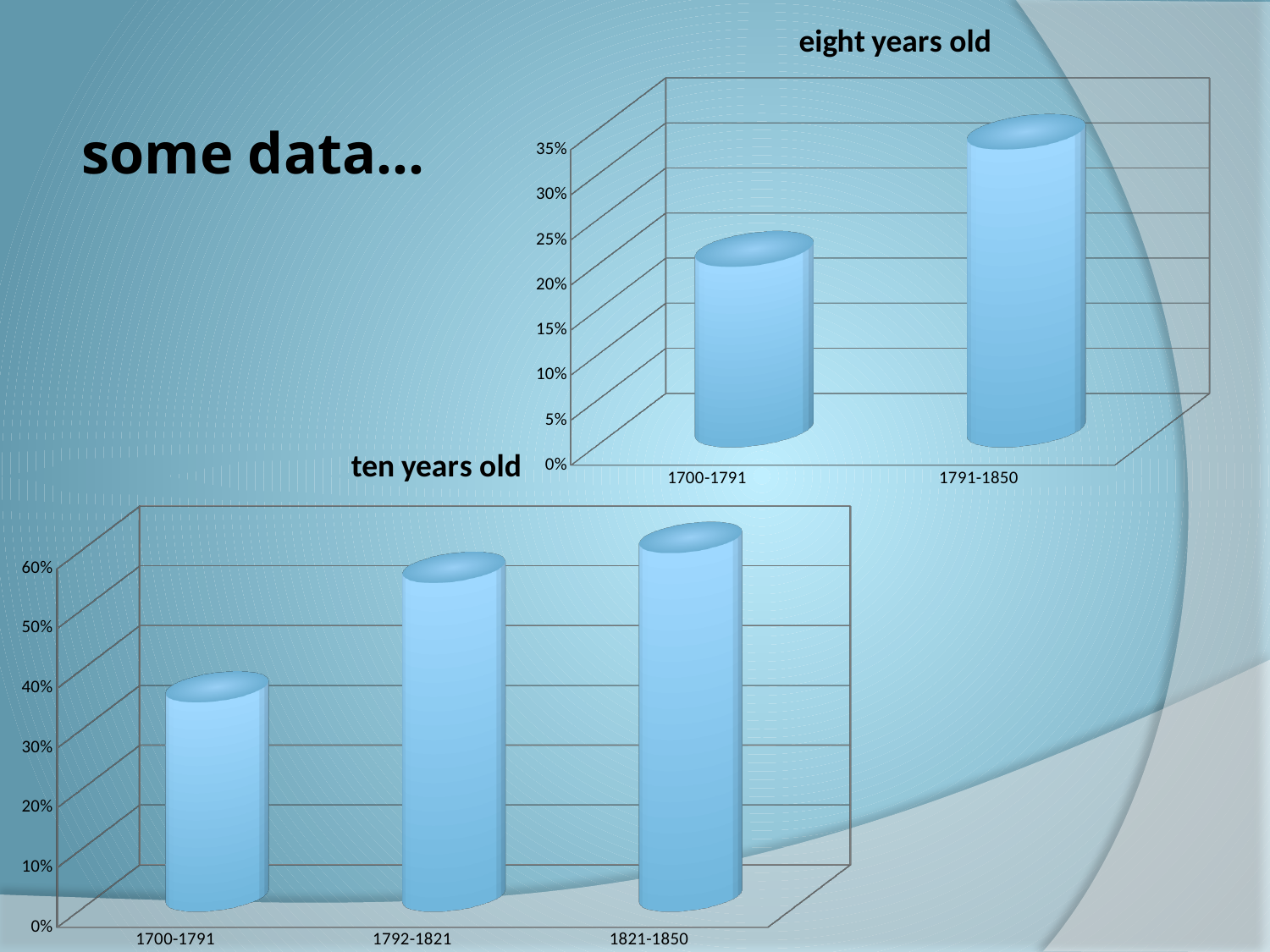
In the "eight years old" chart, is the value for 1700-1791 greater or less than 25%? less In the "ten years old" chart, is the value for 1792-1821 greater or less than 40%? greater In the "ten years old" chart, is the value for 1700-1791 greater or less than 50%? less In the "eight years old" chart, do the values rise or fall from 1700-1791 to 1791-1850? rise In the "ten years old" chart, which period has the lowest value? 1700-1791 How many categories are shown on the "eight years old" chart? 2 How many categories are shown on the "ten years old" chart? 3 In the "ten years old" chart, which period has the highest value? 1821-1850 What kind of chart is the "eight years old" chart? bar chart In the "ten years old" chart, do the values rise or fall across the periods from left to right? rise In the "eight years old" chart, which period has the higher value? 1791-1850